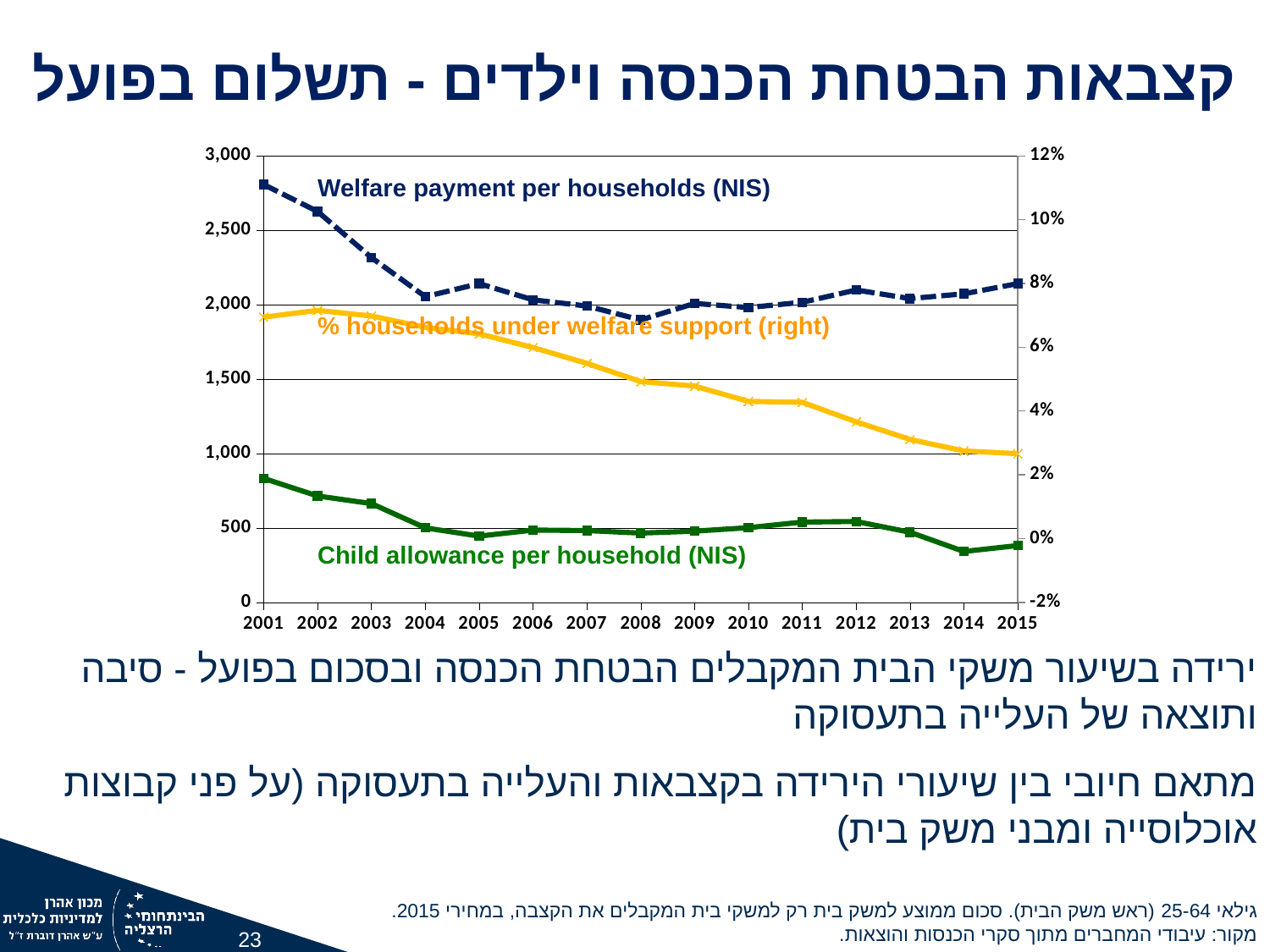
Is the % of households under welfare support in 2015 greater or less than 4%? less Does the welfare payment per household rise or fall from 2001 to 2004? fall Does the % of households under welfare support rise or fall from 2002 to 2015? fall How many data series are plotted on the chart? 3 In which year is the child allowance per household lowest? 2014 Is the welfare payment per household in 2001 greater or less than 2,500? greater What kind of chart is shown on the slide? line chart How many years are shown along the x axis of the chart? 15 Is the child allowance per household in 2001 greater or less than 1,000? less In which year is the welfare payment per household highest? 2001 Which is larger: the welfare payment per household in 2001 or in 2015? 2001 Which axis is used for the '% households under welfare support' series? the right axis